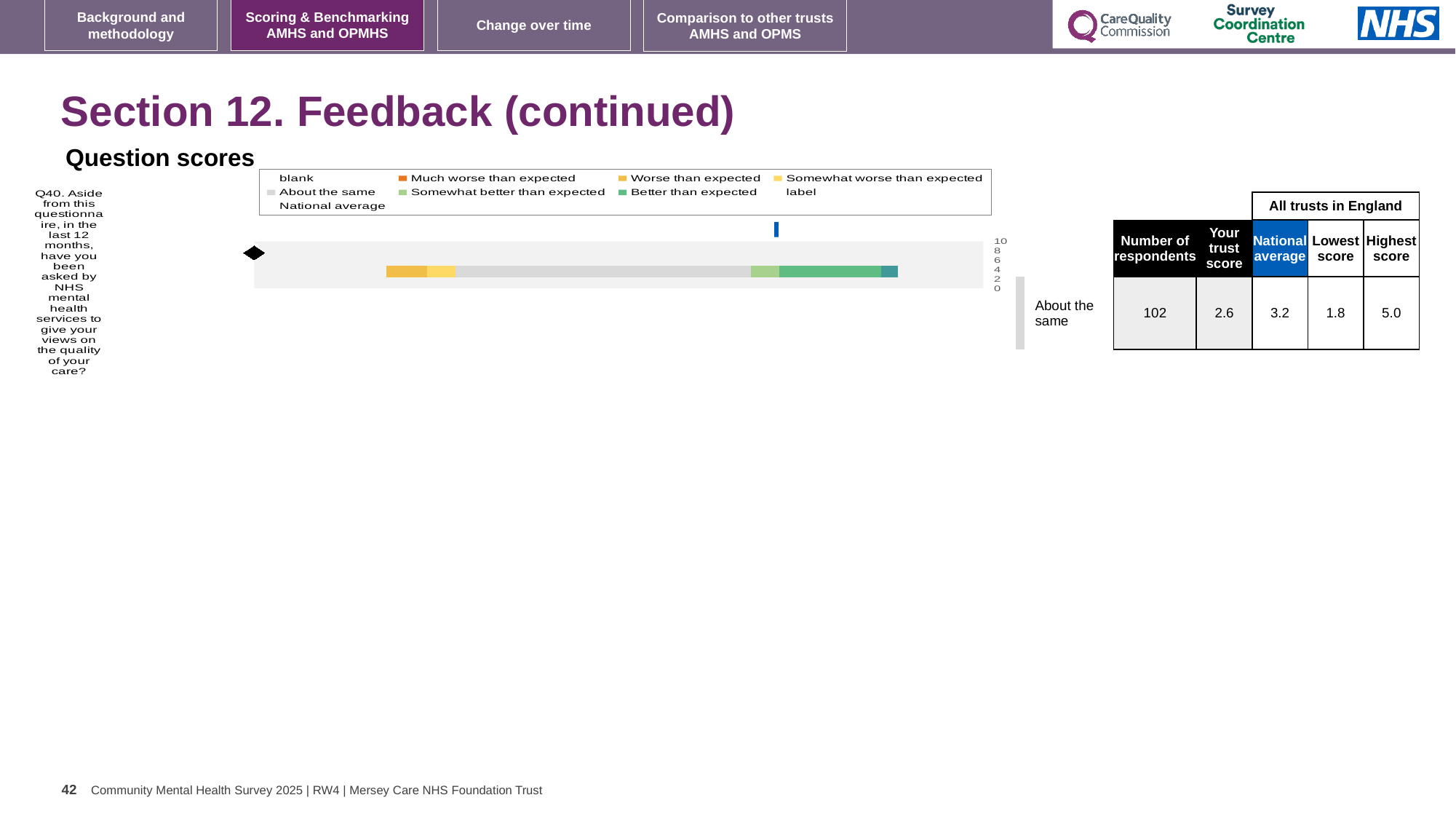
What is the 'Your trust score' for Q40 in the table beside the chart? 2.6 How many questions (categories) are plotted in the Question scores chart? 1 In the Question scores chart legend, which entry is shown in orange? Much worse than expected What is the National average for Q40 in the table beside the chart? 3.2 What is the Lowest score for Q40 among all trusts in England, as shown in the table beside the chart? 1.8 How many entries does the legend of the Question scores chart list? 9 What is the number of respondents for Q40 in the table beside the chart? 102 Which is larger for Q40: the trust score or the National average? National average What is the Highest score for Q40 among all trusts in England, as shown in the table beside the chart? 5.0 What is the difference between the Highest score and the Lowest score for Q40 in the table beside the chart? 3.2 Which question is plotted in the Question scores chart? Q40 What kind of chart is shown under 'Question scores'? bar chart